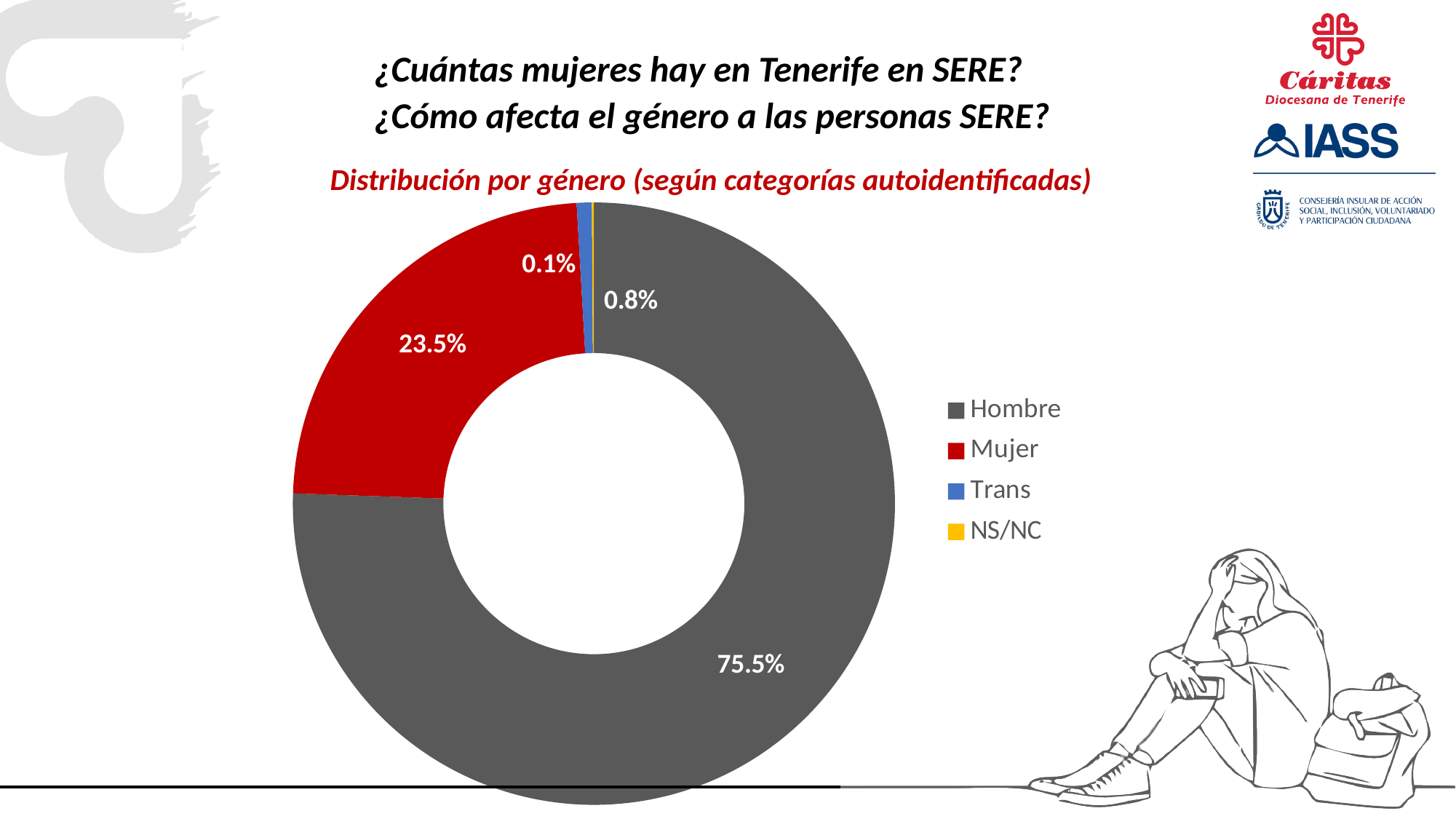
Which is larger, the share for Hombre or the share for Mujer? Hombre What is the smallest percentage value printed on the chart? 0.1% What colour represents Mujer in the chart? Red What is the title of the chart? Distribución por género (según categorías autoidentificadas) Which category has the largest share of the chart? Hombre What percentage of the chart corresponds to Mujer? 23.5% What is the difference in percentage points between the Hombre share and the Mujer share? 52 percentage points Which is larger, the share for Trans or the share for NS/NC? Trans What kind of chart is shown on the slide? Pie chart (doughnut) How many categories does the legend list? 4 Which category has the smallest share of the chart? NS/NC What percentage of the chart corresponds to Hombre? 75.5%